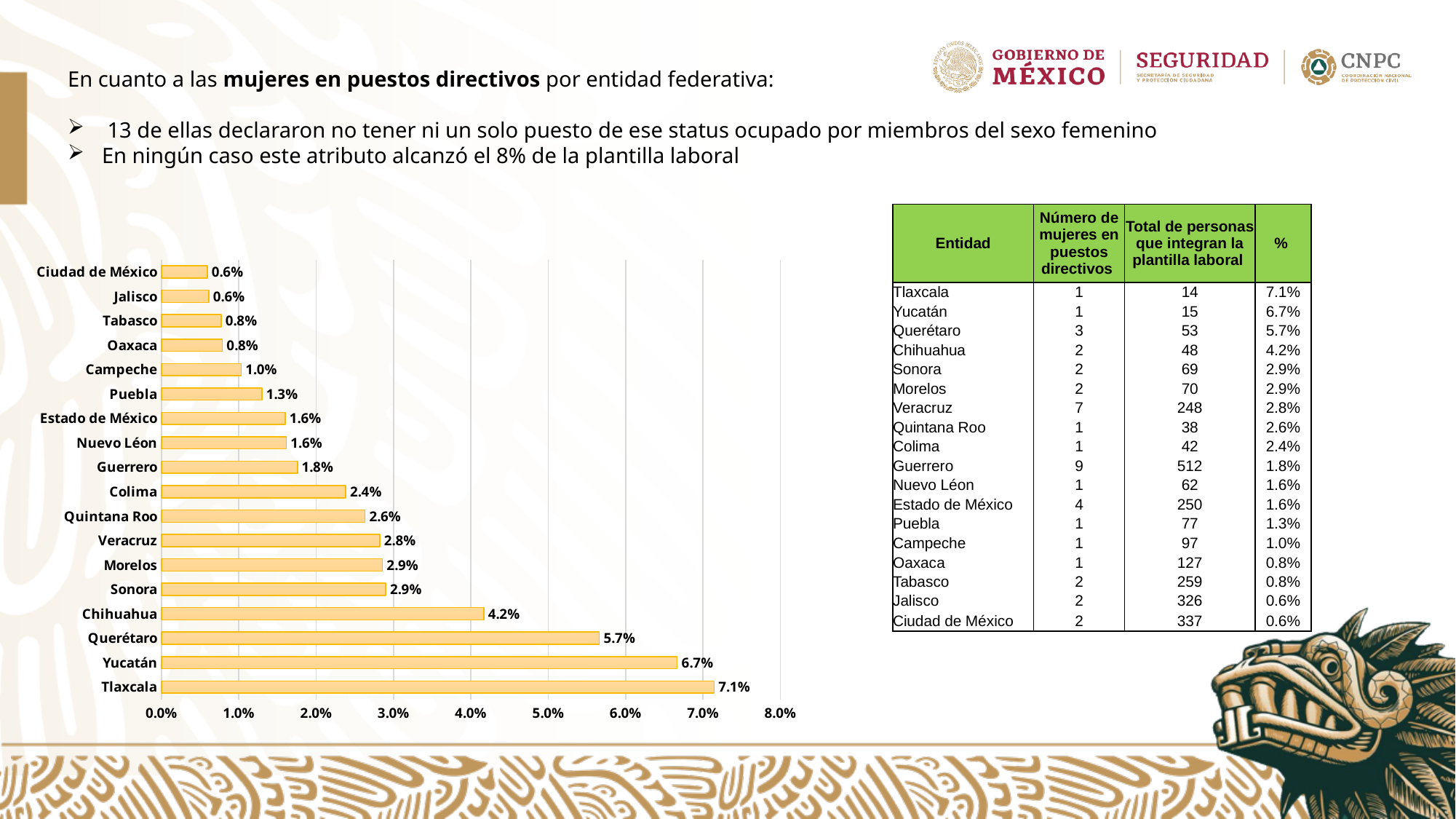
How many entities are shown in the bar chart? 18 What is the value for Guerrero in the bar chart? 1.8% What is the maximum value shown on the x axis of the bar chart? 8.0% Which entity has the highest value in the bar chart? Tlaxcala Which has a larger value in the bar chart, Colima or Puebla? Colima What is the difference between the values for Tlaxcala and Ciudad de México in the bar chart? 6.5% What is the value for Chihuahua in the bar chart? 4.2% What is the difference between the values for Querétaro and Yucatán in the bar chart? 1.0% Is the value for Querétaro in the bar chart greater or less than 5.0%? greater What kind of chart is shown on the slide? bar chart Is the value for Campeche in the bar chart greater or less than 2.0%? less What is the value for Tlaxcala in the bar chart? 7.1%